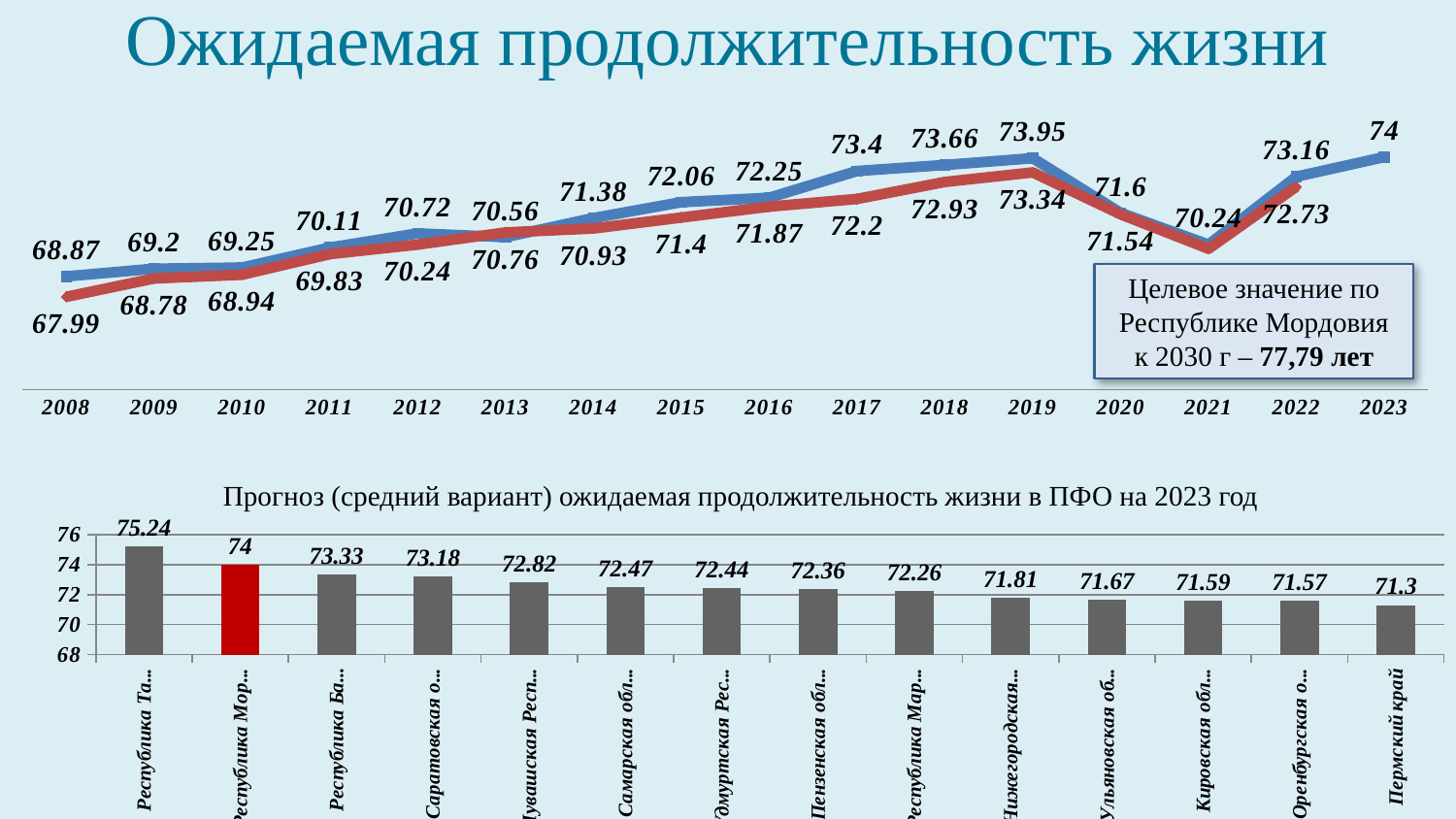
In the top line chart, what value is labelled on the upper (blue) line for 2023? 74 In the top line chart, how many years are shown on the x axis? 16 In the top line chart, do the values of the upper (blue) line rise or fall from 2008 to 2019? rise In the top line chart, what value is labelled on the lower (red) line for 2008? 67.99 In the bottom bar chart, which region has the highest value? Республика Та... In the bottom bar chart, what is the value for Пермский край? 71.3 What type of chart is the bottom chart titled 'Прогноз (средний вариант) ожидаемая продолжительность жизни в ПФО на 2023 год'? bar chart In the top line chart, what is the difference between the upper (blue) line values for 2019 (73.95) and 2020 (71.6)? 2.35 In the bottom bar chart, which region has the lowest value? Пермский край What target value for the Republic of Mordovia by 2030 is stated in the text box on the top chart? 77,79 лет In the bottom bar chart, how many regions (bars) are shown? 14 In the top line chart, what value is labelled on the upper (blue) line for 2019? 73.95